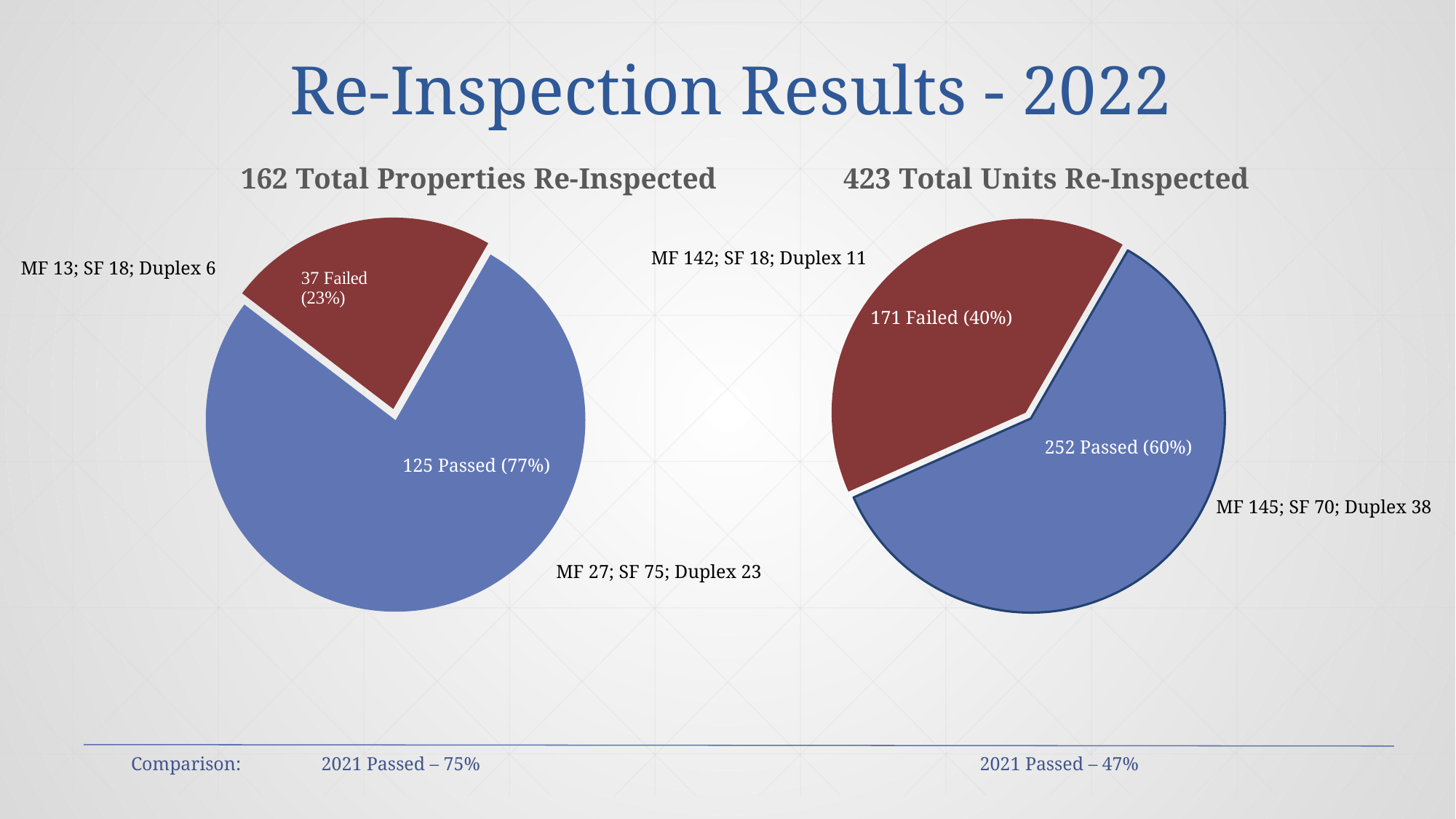
In the '162 Total Properties Re-Inspected' chart, which slice is the largest? Passed In the '423 Total Units Re-Inspected' chart, what is the difference between the number of units passed and the number failed? 81 In the '162 Total Properties Re-Inspected' chart, how many properties passed? 125 What type of chart is the '162 Total Properties Re-Inspected' chart? pie chart In the '423 Total Units Re-Inspected' chart, which slice is the smallest? Failed In the '423 Total Units Re-Inspected' chart, what share of the pie is the Failed slice? 40% In the '162 Total Properties Re-Inspected' chart, is the number of properties passed larger or smaller than the number failed? larger In the '423 Total Units Re-Inspected' chart, how many units failed? 171 In the '423 Total Units Re-Inspected' chart, how many units passed? 252 In the '162 Total Properties Re-Inspected' chart, how many properties failed? 37 How many slices does the '423 Total Units Re-Inspected' chart have? 2 In the '162 Total Properties Re-Inspected' chart, what share of the pie is the Passed slice? 77%